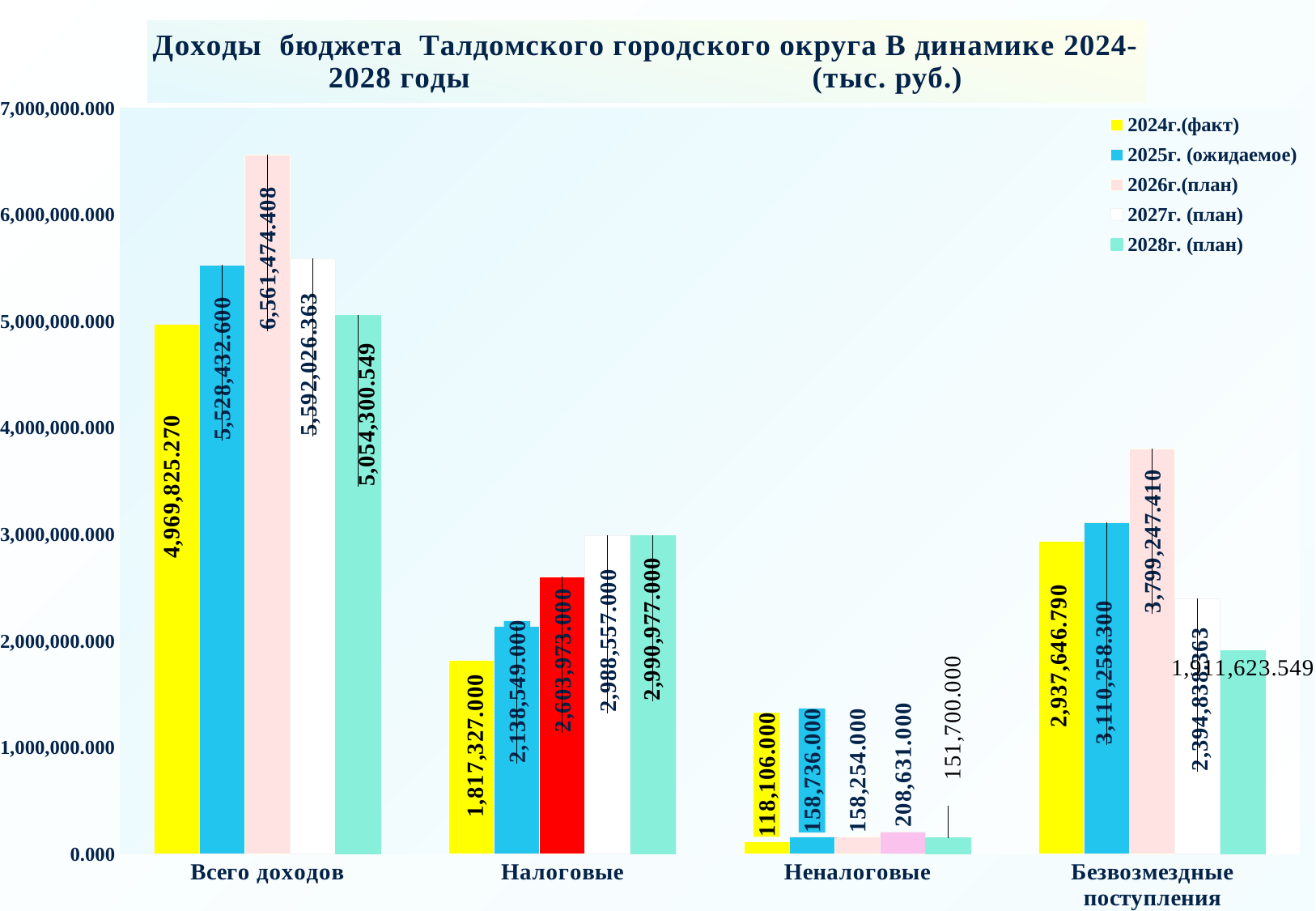
What is the difference between the 2025г. (ожидаемое) and 2024г.(факт) values in the Всего доходов category? 558,607.330 In the Безвозмездные поступления category, which is larger: the 2024г.(факт) value or the 2025г. (ожидаемое) value? 2025г. (ожидаемое) How many categories are shown on the x axis? 4 What is the value for 2024г.(факт) in the Всего доходов category? 4,969,825.270 What is the value for 2026г.(план) in the Всего доходов category? 6,561,474.408 Which series has the lowest value in the Неналоговые category? 2024г.(факт) What is the difference between the 2028г. (план) and 2027г. (план) values in the Налоговые category? 2,420.000 How many series does the legend list? 5 What is the value for 2027г. (план) in the Неналоговые category? 208,631.000 Is the value for 2028г. (план) in the Безвозмездные поступления category greater or less than 2,000,000.000? less Which series has the highest value in the Всего доходов category? 2026г.(план) What kind of chart is shown on the slide? bar chart